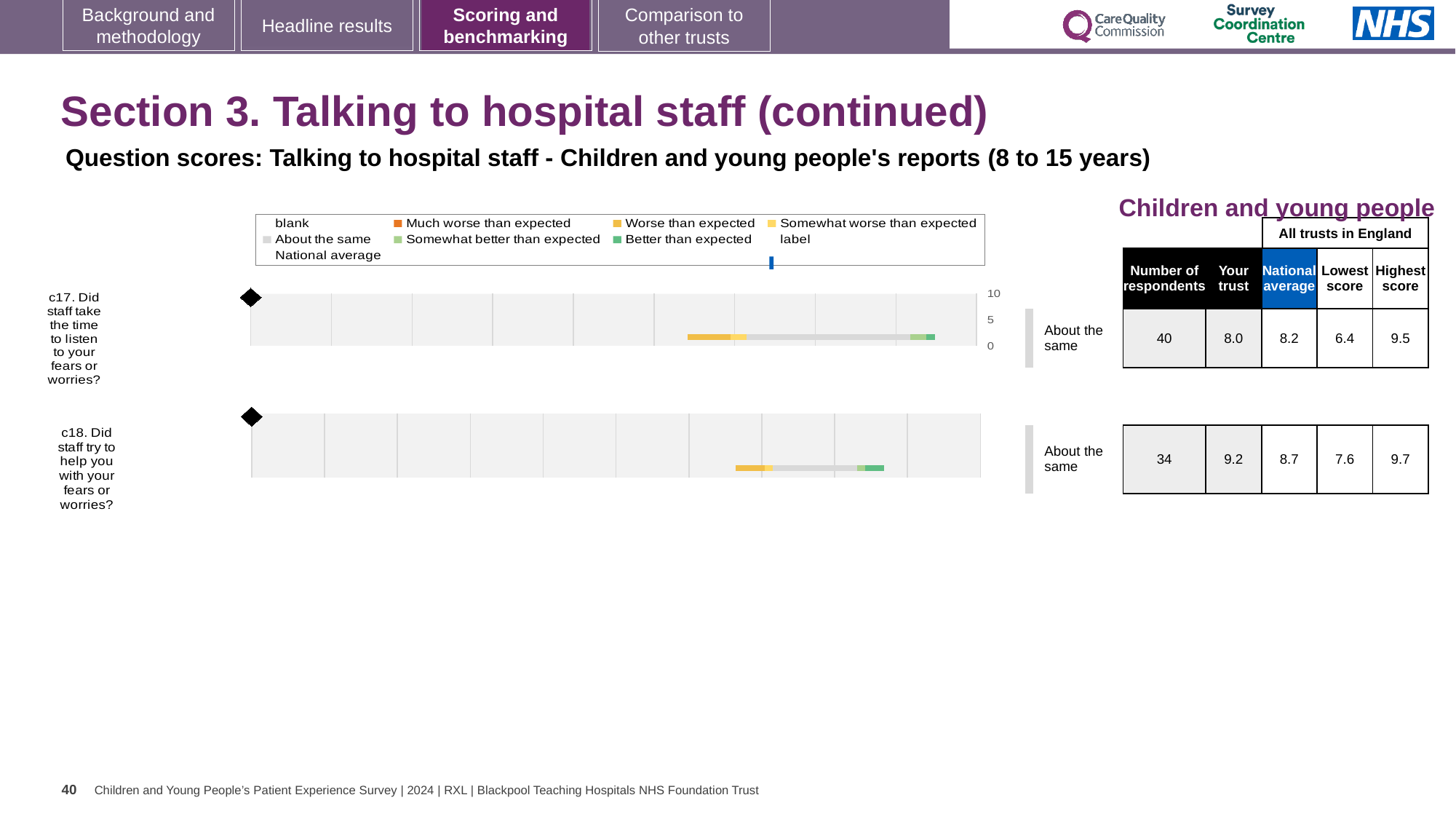
What is the 'Your trust' score for c17 (Did staff take the time to listen to your fears or worries?)? 8.0 What is the 'Your trust' score for c18 (Did staff try to help you with your fears or worries?)? 9.2 What is the national average score for c17? 8.2 How many entries does the chart legend list? 9 How many respondents answered c18? 34 How many questions (c17 and c18) are plotted on the slide? 2 Which question has the higher 'Your trust' score, c17 or c18? c18 What benchmark category is shown for c17? About the same What kind of chart is used to show the question scores for c17 and c18? bar chart What is the difference between the highest and lowest scores for c17? 3.1 What is the highest score among all trusts in England for c18? 9.7 What is the difference between the 'Your trust' score and the national average for c18? 0.5